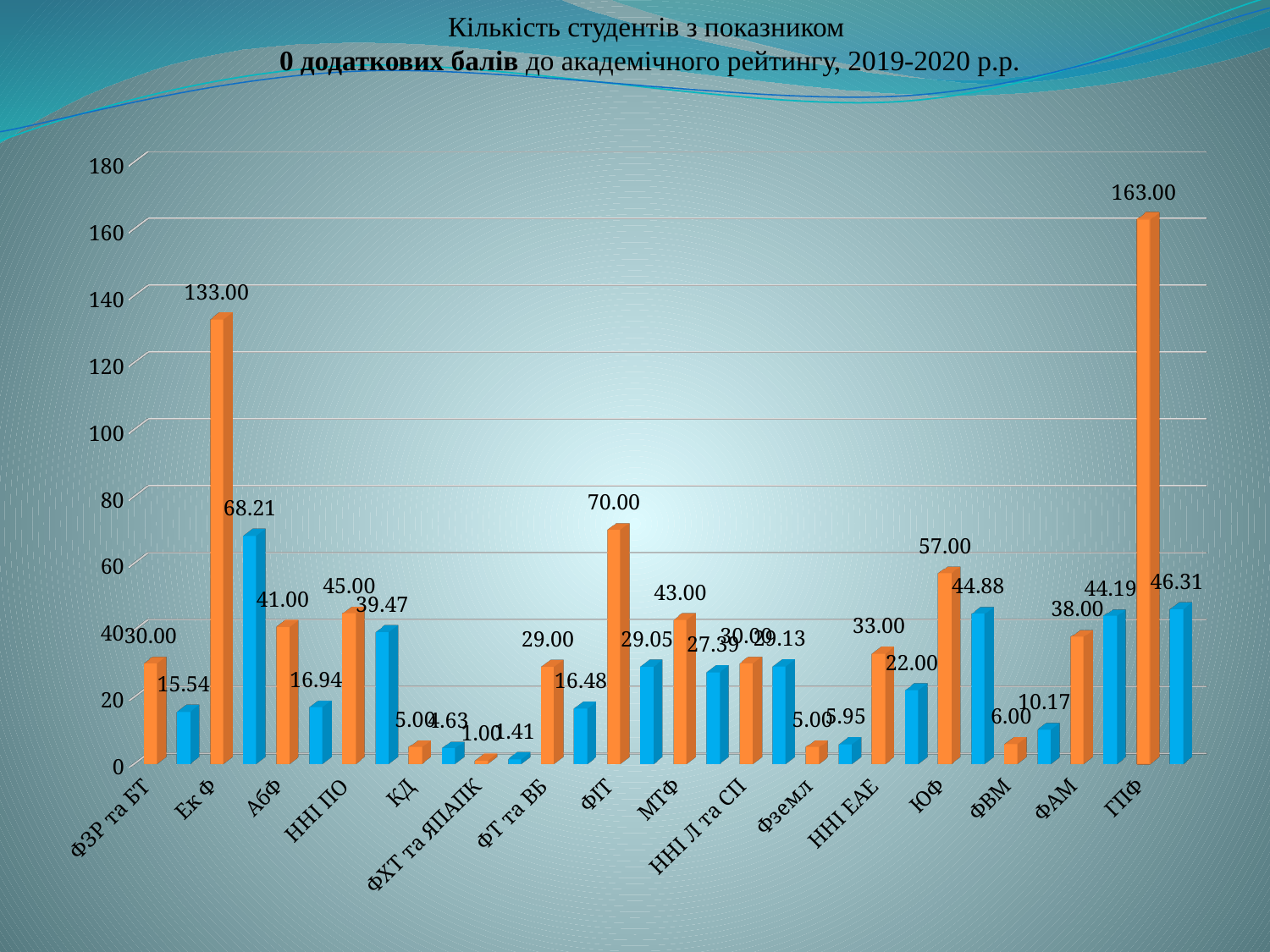
What kind of chart is shown on the slide? bar chart Is the orange bar for ЮФ greater or less than 40? greater What is the value of the blue bar for ЮФ? 44.88 What is the difference between the orange and blue bars for ФІТ? 40.95 What is the value of the orange bar for ФІТ? 70.00 What is the difference between the orange bars for ГПФ and Ек Ф? 30.00 How many categories are shown on the x axis? 16 Which is larger for ФАМ, the orange bar or the blue bar? the blue bar What is the value of the blue bar for Ек Ф? 68.21 Which category has the highest orange bar? ГПФ What is the value of the orange bar for ГПФ? 163.00 Which category has the lowest orange bar? ФХТ та ЯПАПК